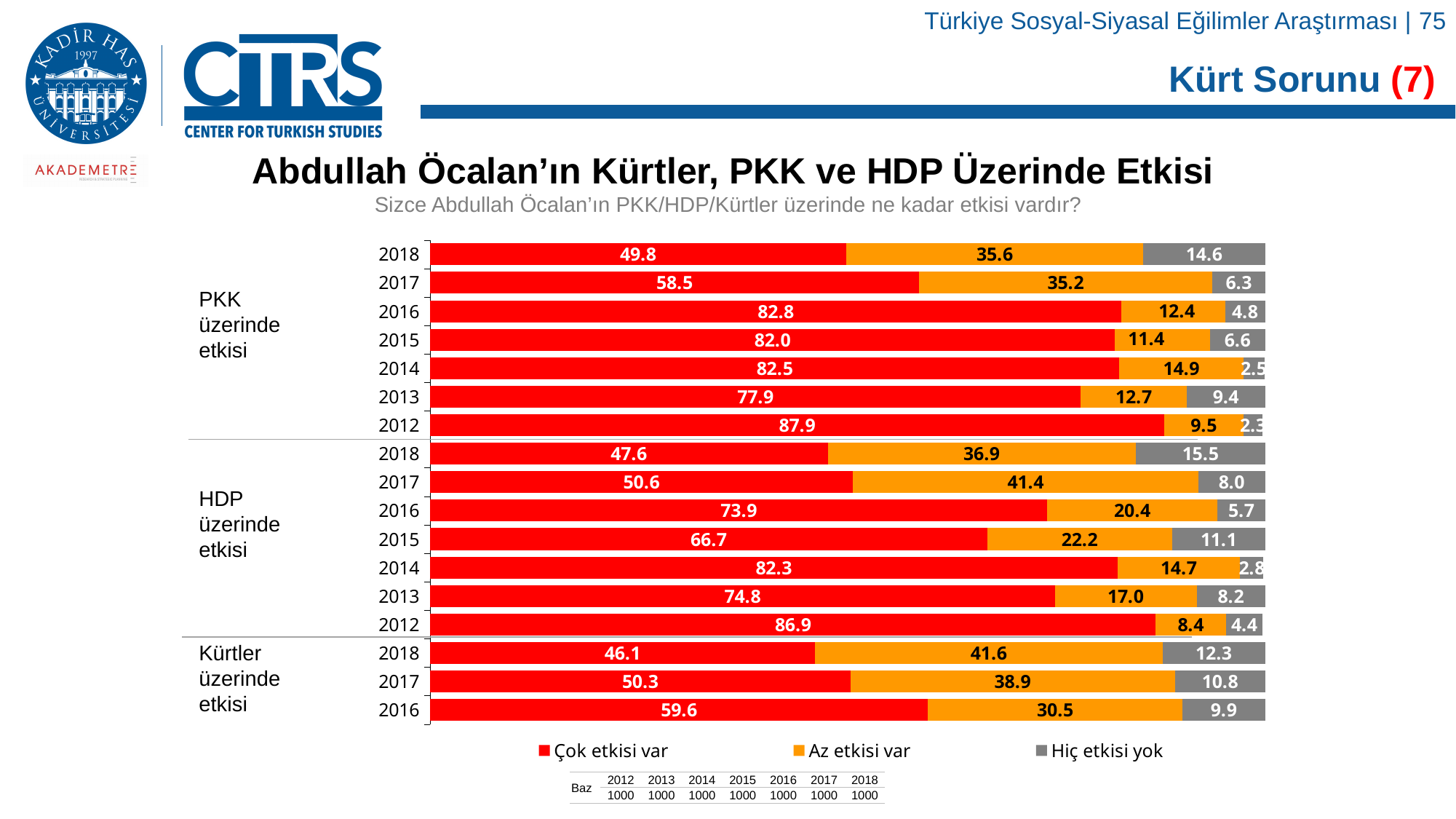
What is the value of "Az etkisi var" for Kürtler üzerinde etkisi in 2016? 30.5 Which is larger: the "Çok etkisi var" value for PKK üzerinde etkisi in 2016 or for HDP üzerinde etkisi in 2016? PKK üzerinde etkisi 2016 What is the difference between the "Çok etkisi var" values for PKK üzerinde etkisi in 2017 and 2018? 8.7 Within the PKK üzerinde etkisi group, which year has the highest "Çok etkisi var" value? 2012 What kind of chart is shown on the slide? Stacked bar chart Within the HDP üzerinde etkisi group, which year has the lowest "Çok etkisi var" value? 2018 What is the total of the stacked bar for PKK üzerinde etkisi in 2018? 100.0 How many series does the legend list? 3 What is the value of "Hiç etkisi yok" for HDP üzerinde etkisi in 2015? 11.1 How many years are shown for the Kürtler üzerinde etkisi group? 3 Does the "Çok etkisi var" value for Kürtler üzerinde etkisi rise or fall from 2016 to 2018? Fall What is the value of "Çok etkisi var" for PKK üzerinde etkisi in 2018? 49.8